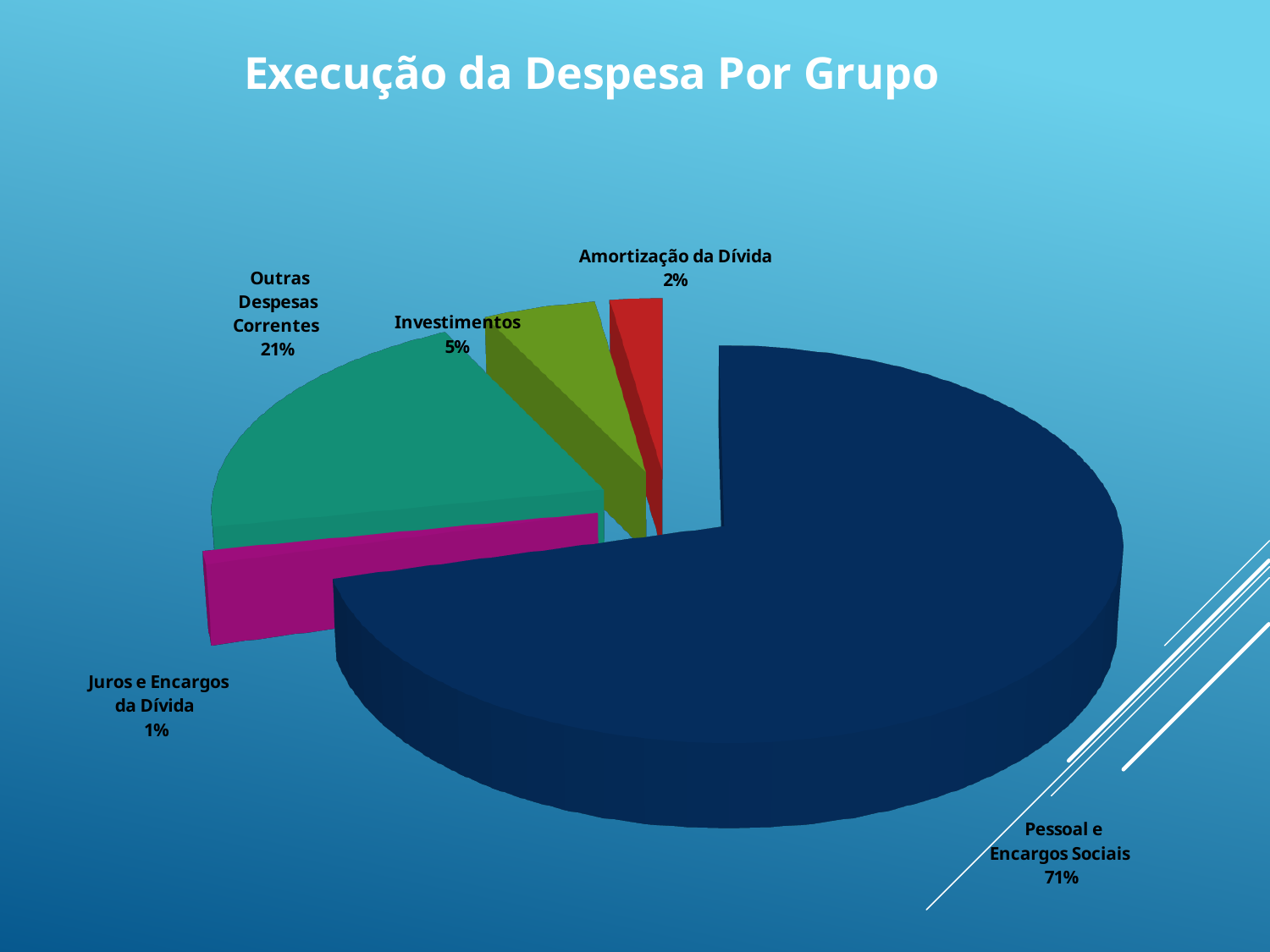
What is the title of the chart? Execução da Despesa Por Grupo Which category has the smallest slice of the pie? Juros e Encargos da Dívida What is the value shown for Investimentos? 5% What is the value shown for Amortização da Dívida? 2% What share of the pie does Pessoal e Encargos Sociais represent? 71% What kind of chart is shown on the slide? Pie chart Which is larger, Investimentos or Amortização da Dívida? Investimentos What is the difference in percentage points between Pessoal e Encargos Sociais and Outras Despesas Correntes? 50 What is the value shown for Outras Despesas Correntes? 21% Which category has the largest slice of the pie? Pessoal e Encargos Sociais What is the value shown for Juros e Encargos da Dívida? 1% How many categories are shown in the pie chart? 5